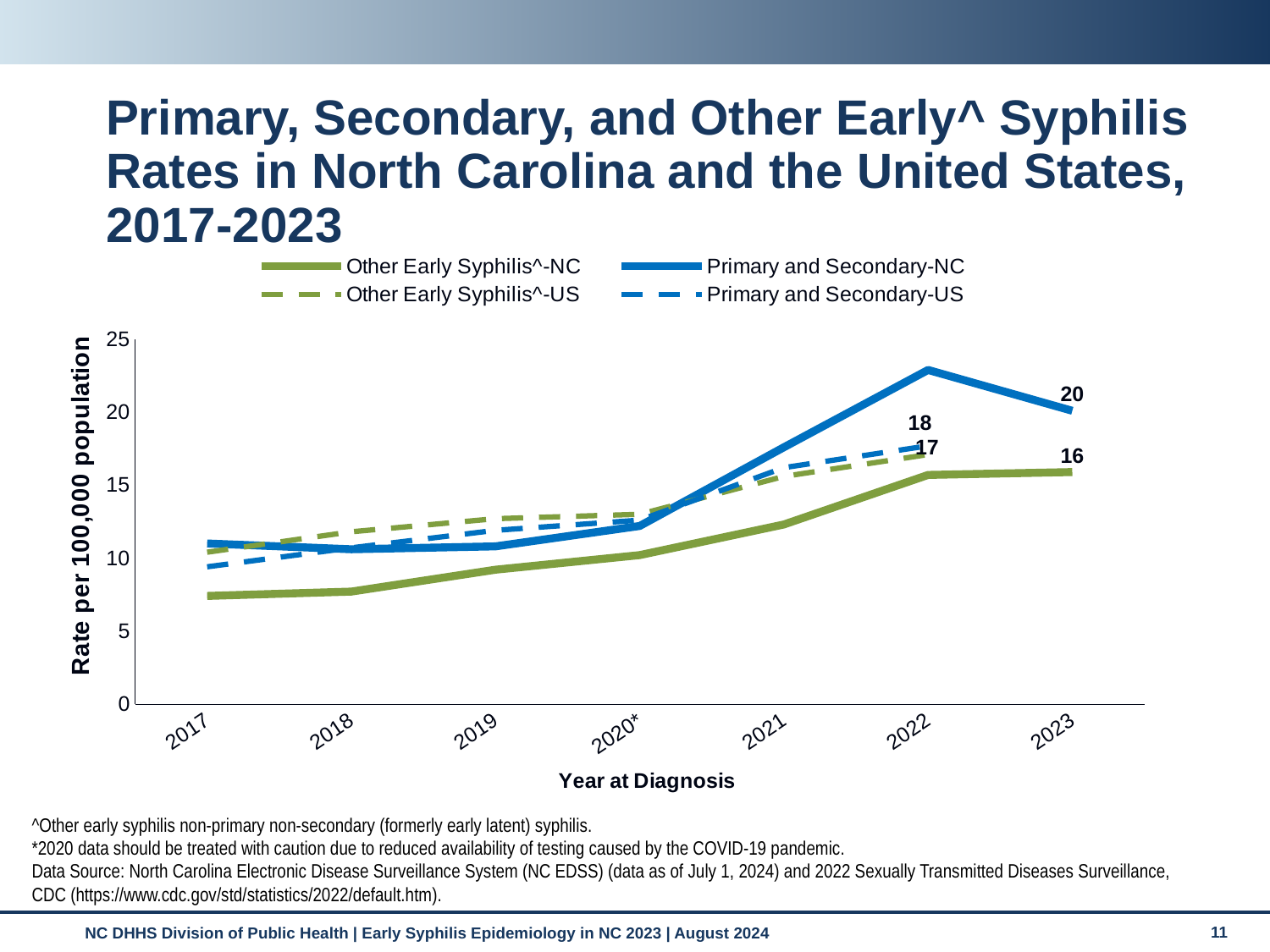
In which year does the Primary and Secondary-NC line reach its highest point? 2022 How many series does the legend list? 4 What is the difference between the Primary and Secondary-NC rate and the Other Early Syphilis^-NC rate in 2023? 4 In 2023, which is larger: the Primary and Secondary-NC rate or the Other Early Syphilis^-NC rate? Primary and Secondary-NC What is the Other Early Syphilis^-NC rate in 2023? 16 What is the Primary and Secondary-US rate in 2022? 18 Is the Primary and Secondary-NC rate in 2022 greater or less than 20? greater What is the Primary and Secondary-NC rate in 2023? 20 How many years are plotted along the x axis? 7 What is the Other Early Syphilis^-US rate in 2022? 17 What is the label on the y axis? Rate per 100,000 population What kind of chart is shown on the slide? Line chart